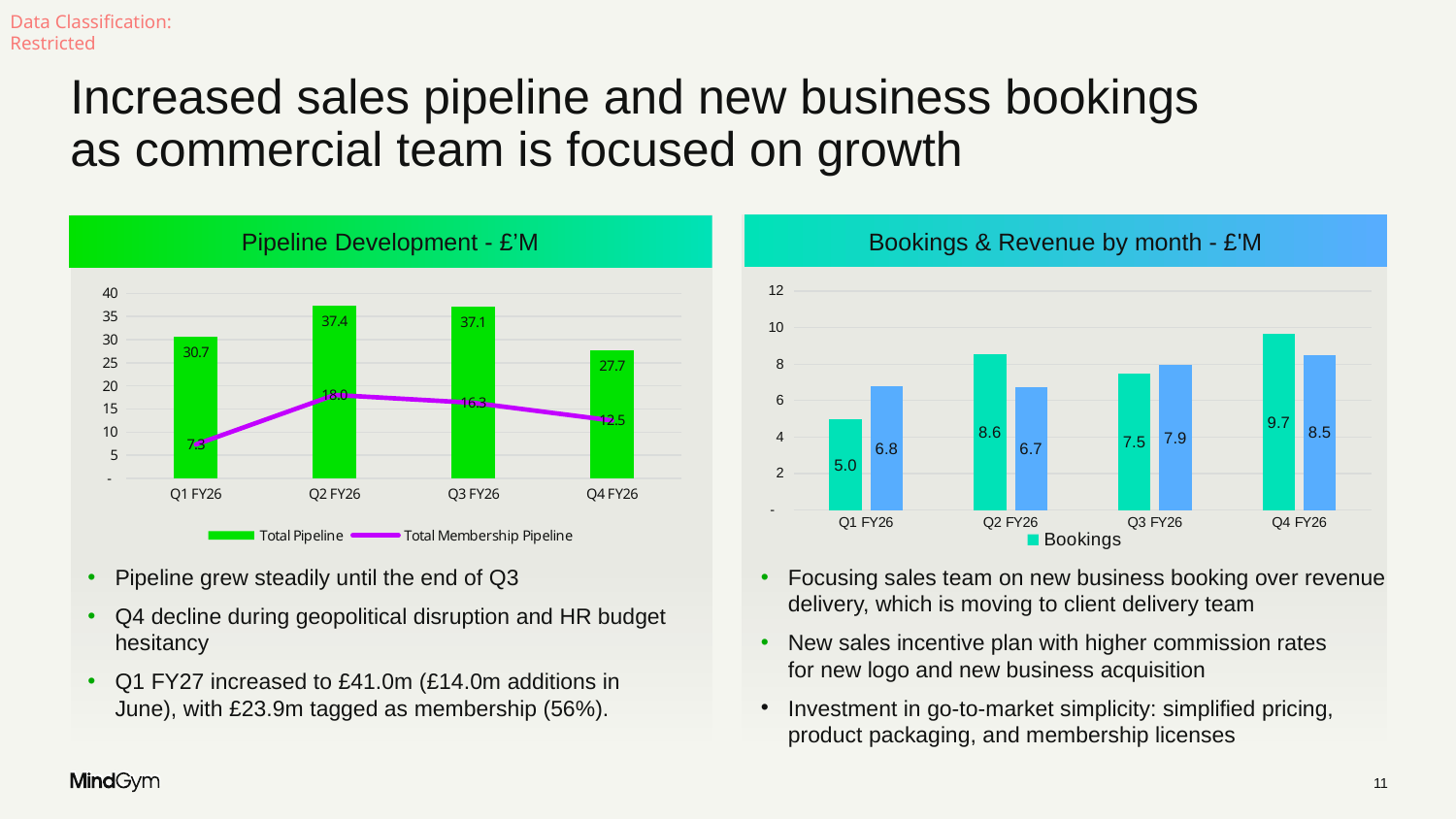
In the Pipeline Development chart, which quarter has the lowest Total Pipeline? Q4 FY26 In the Pipeline Development chart, how many series does the legend list? 2 In the Pipeline Development chart, does the Total Membership Pipeline rise or fall from Q2 FY26 to Q4 FY26? fall In the Pipeline Development chart, what is the difference between the Total Pipeline in Q2 FY26 and Q4 FY26? 9.7 In the Bookings & Revenue by month chart, which is larger: Bookings in Q2 FY26 or Bookings in Q3 FY26? Q2 FY26 In the Bookings & Revenue by month chart, which quarter has the lowest Bookings? Q1 FY26 In the Bookings & Revenue by month chart, what is the Bookings value for Q4 FY26? 9.7 In the Bookings & Revenue by month chart, what is the difference between Bookings in Q4 FY26 and Q1 FY26? 4.7 In the Pipeline Development chart, what is the Total Pipeline value for Q2 FY26? 37.4 How many quarters are shown on the x axis of the Bookings & Revenue by month chart? 4 In the Pipeline Development chart, what is the Total Membership Pipeline value for Q2 FY26? 18.0 What type of chart is the Bookings & Revenue by month chart? bar chart